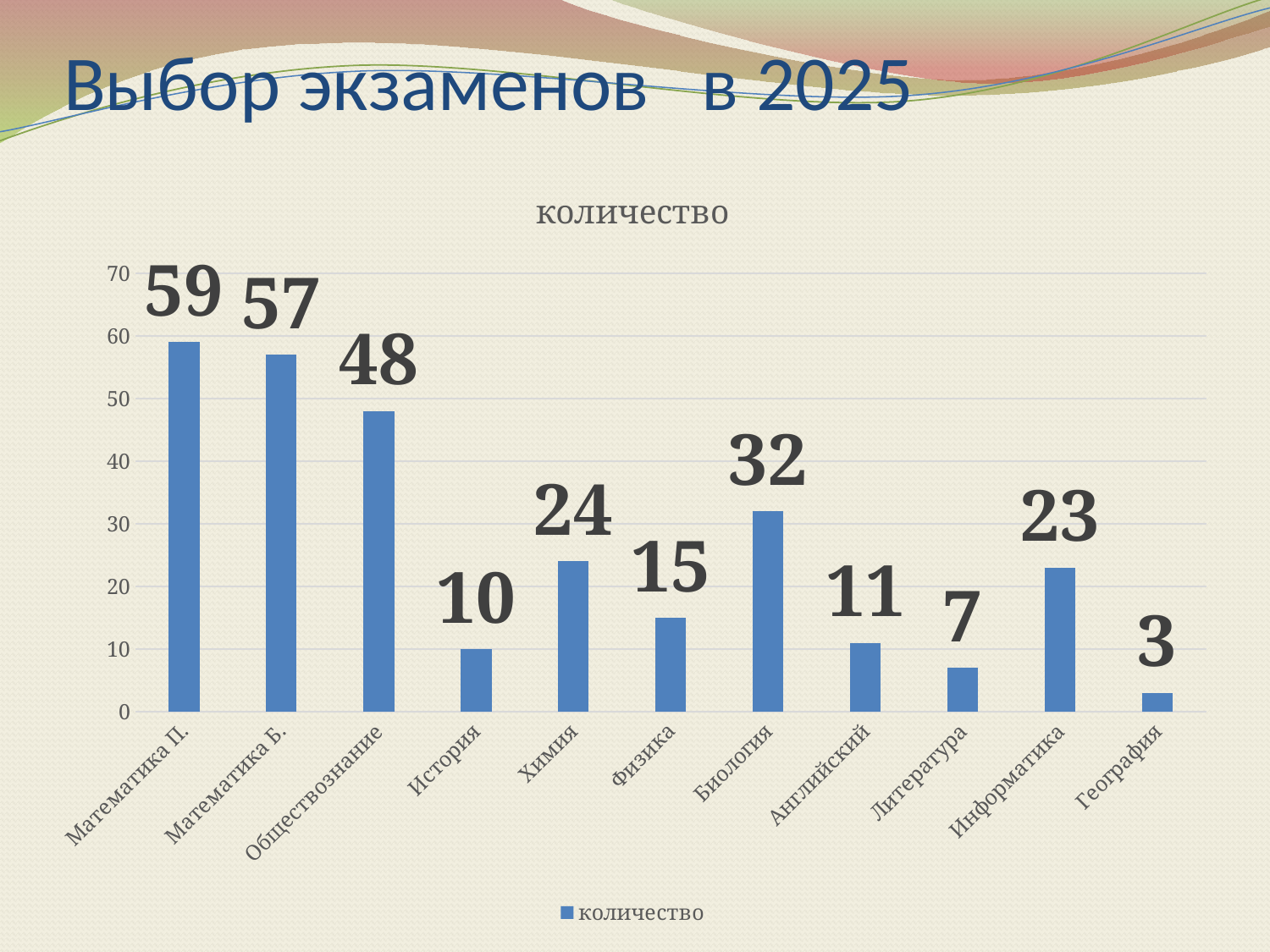
What is the difference between the values for Обществознание and Биология? 16 What is the difference between the values for Математика П. and Математика Б.? 2 Which category has the lowest value? География Which is larger, the value for Английский or the value for Литература? Английский Which is larger, the value for Химия or the value for Физика? Химия What is the title of the chart? количество What is the value for Информатика? 23 What is the value for Биология? 32 Which category has the highest value? Математика П. How many categories are shown on the x axis? 11 What kind of chart is shown on the slide? bar chart What is the value for История? 10